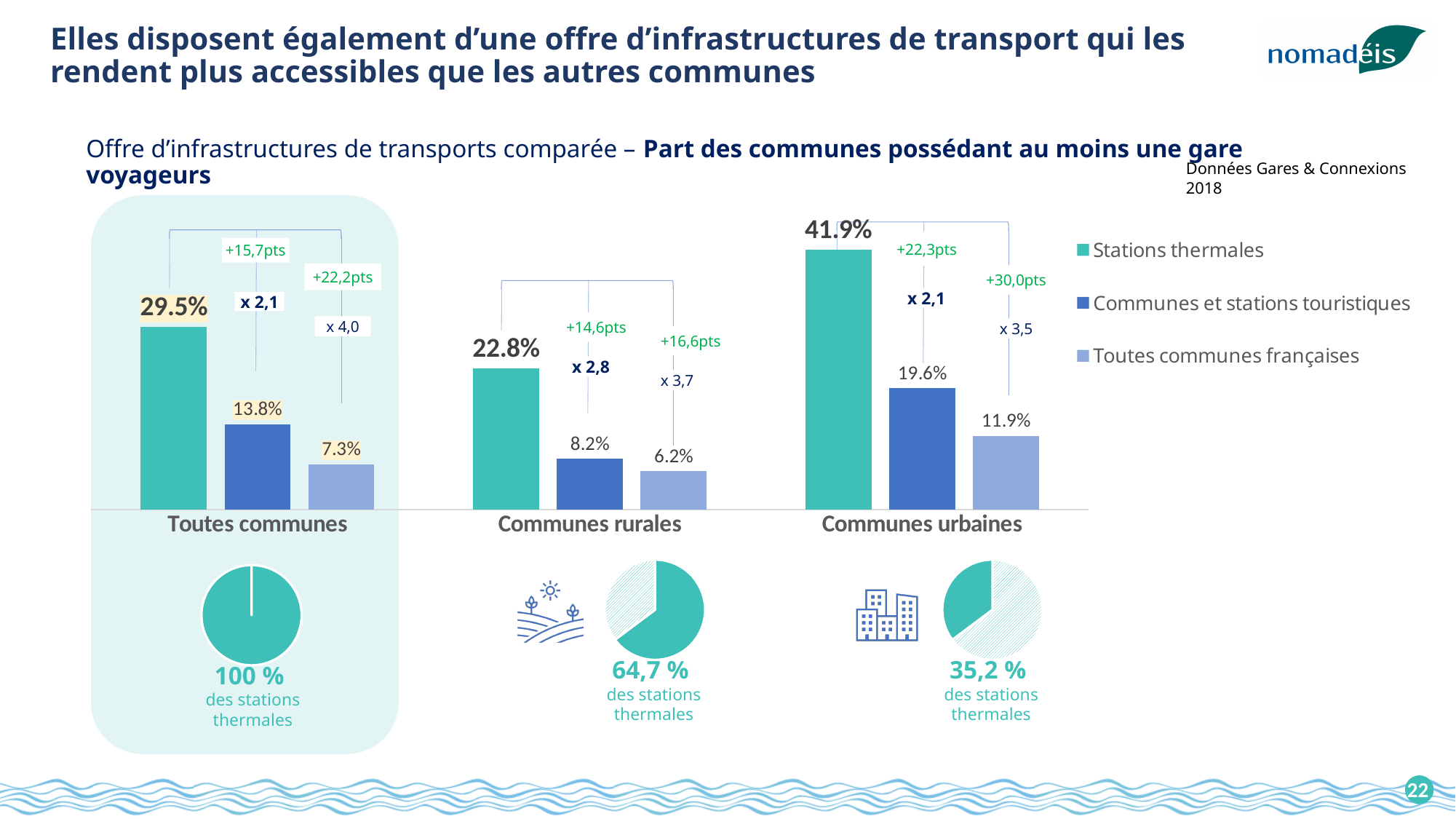
In the bar chart, what is the difference between Stations thermales and Toutes communes françaises in the Communes urbaines group? 30,0pts In the bar chart, what is the value for Toutes communes françaises in the Communes rurales group? 6.2% How many series does the bar chart legend list? 3 In the pie chart under Communes rurales, what share of stations thermales is shown? 64,7 % In the bar chart, which series has the lowest value in the Communes urbaines group? Toutes communes françaises In the bar chart, what is the difference between Stations thermales and Communes et stations touristiques in the Toutes communes group? 15,7pts How many category groups are shown on the x axis of the bar chart? 3 In the bar chart, which group has the highest value for Stations thermales? Communes urbaines In the bar chart, what is the value for Communes et stations touristiques in the Toutes communes group? 13.8% In the bar chart, which is larger: Communes et stations touristiques in Communes rurales or Toutes communes françaises in Communes urbaines? Toutes communes françaises in Communes urbaines In the bar chart, what is the value for Stations thermales in the Communes urbaines group? 41.9% What type of chart is the main chart on the slide? Bar chart